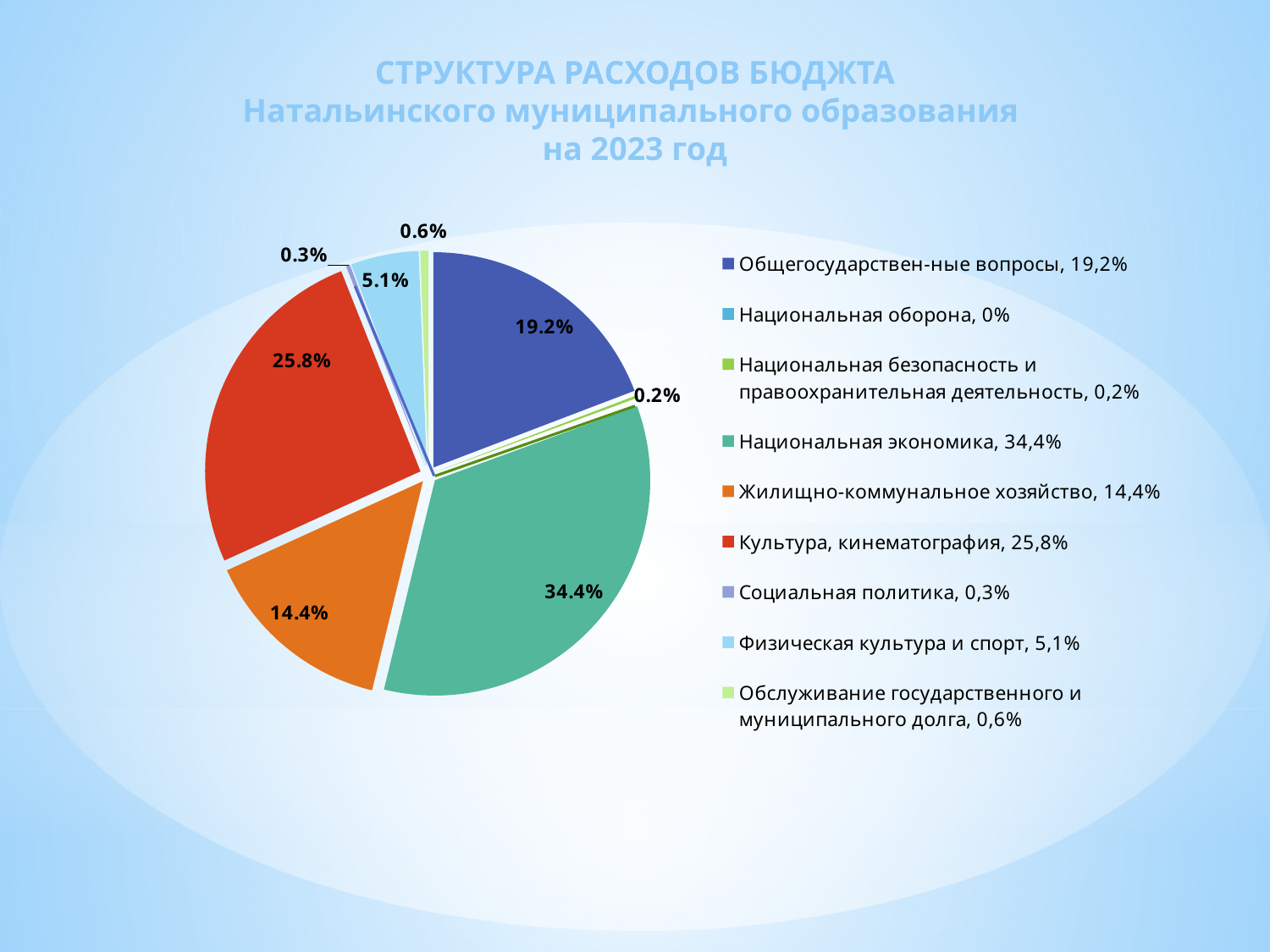
Which category has the smallest share of the pie? Национальная оборона What is the value shown for Культура, кинематография? 25.8% How many categories does the legend list? 9 What share of the pie does Национальная экономика account for? 34.4% What is the value shown for Социальная политика? 0.3% What is the value shown for Физическая культура и спорт? 5.1% What is the value shown for Жилищно-коммунальное хозяйство? 14.4% What is the difference in percentage points between Общегосударственные вопросы and Жилищно-коммунальное хозяйство? 4.8 Which category has the largest share of the pie? Национальная экономика What is the difference in percentage points between Национальная экономика and Культура, кинематография? 8.6 Which is larger: Общегосударственные вопросы or Жилищно-коммунальное хозяйство? Общегосударственные вопросы What kind of chart is shown on the slide? Pie chart